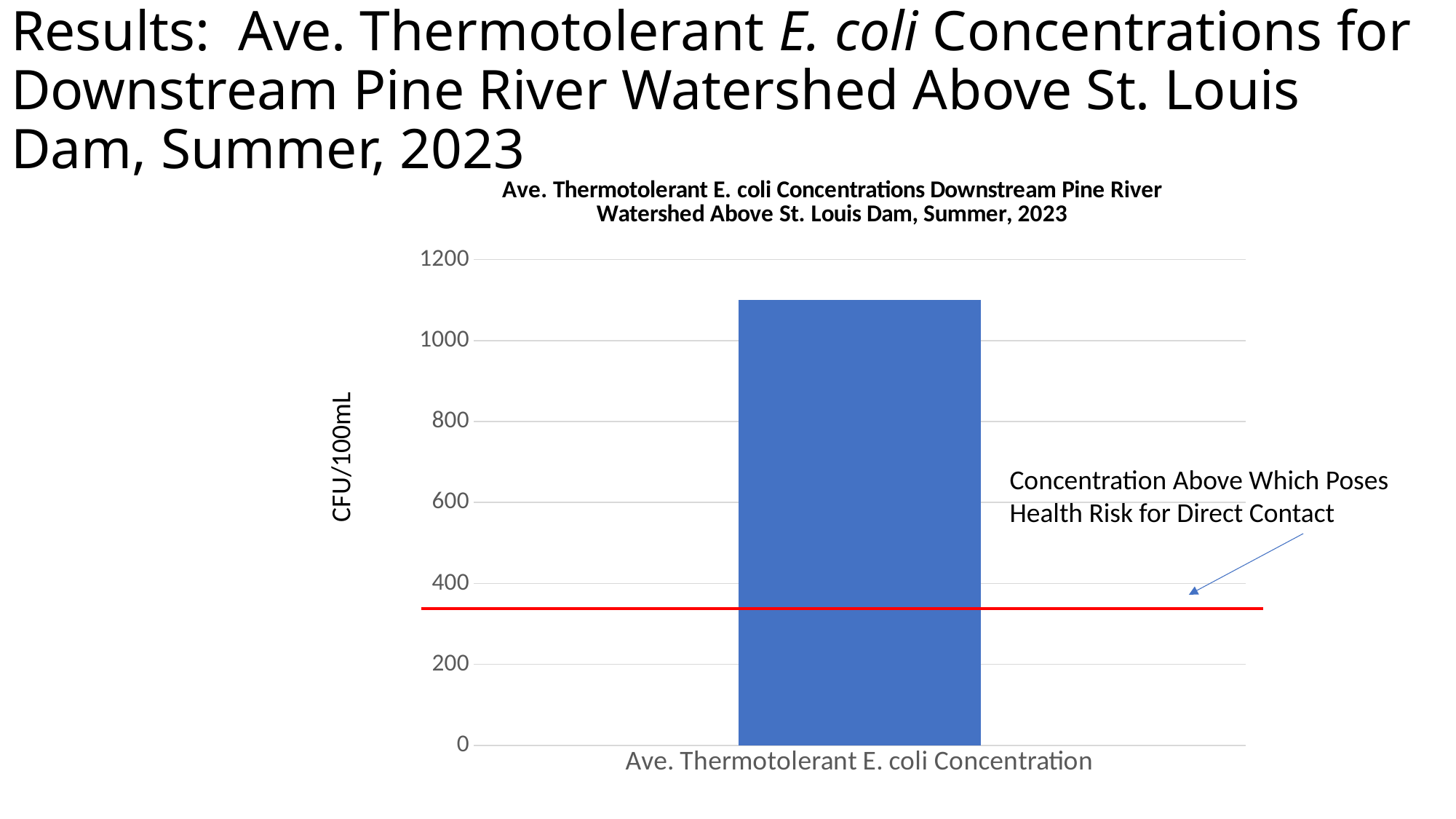
What does the red horizontal line on the chart represent, according to the annotation? Concentration Above Which Poses Health Risk for Direct Contact Is the value for Ave. Thermotolerant E. coli Concentration greater or less than 1200? less What kind of chart is shown on the slide? bar chart Is the red horizontal line on the chart above or below the 200 gridline? above Is the red horizontal line on the chart above or below the 400 gridline? below What is the highest value shown on the vertical axis of the chart? 1200 What is the label on the vertical axis of the chart? CFU/100mL How many bars are plotted in the chart? 1 Does the bar extend above or stay below the red horizontal line? above